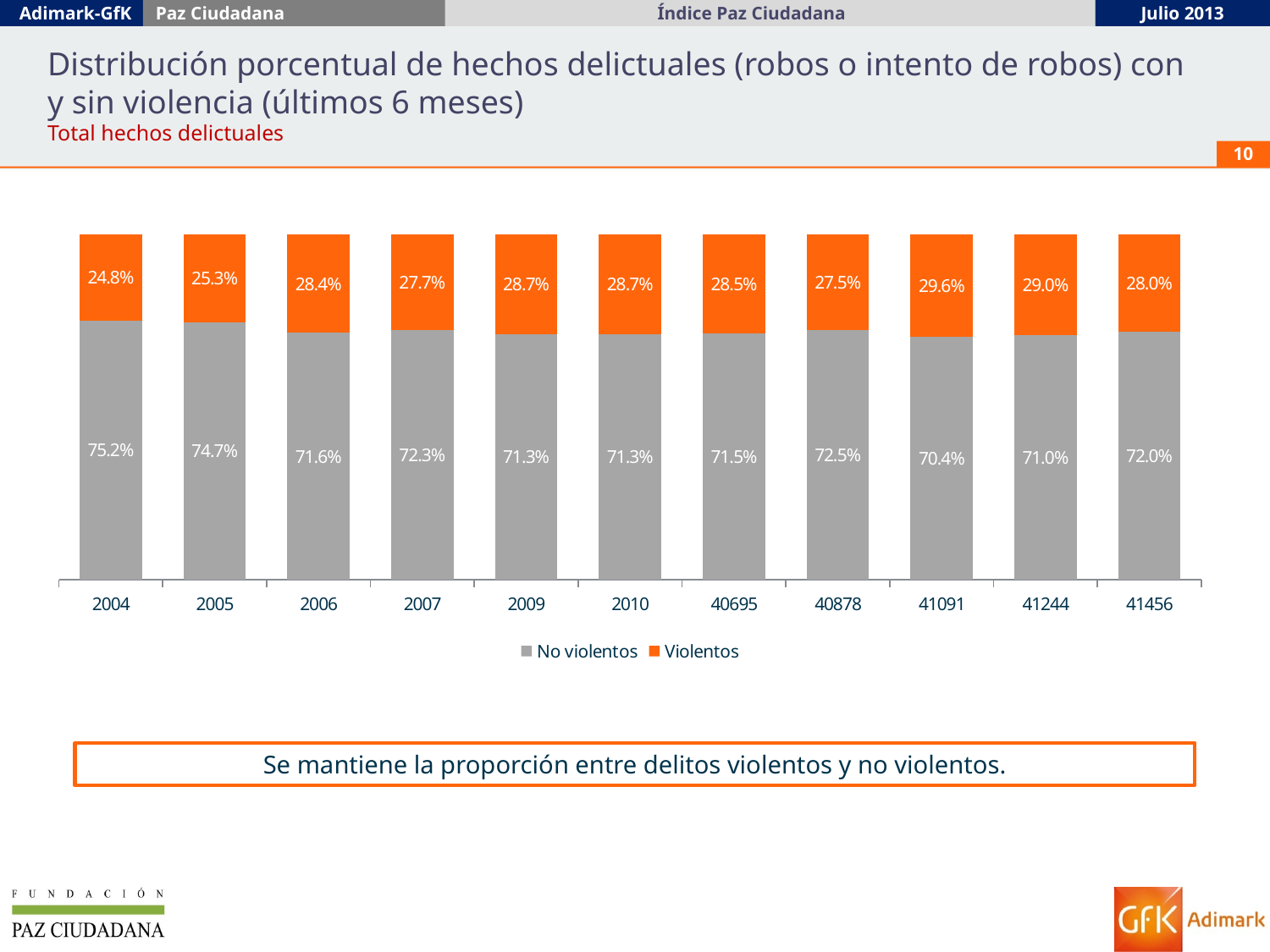
Which category has the highest value for No violentos? 2004 Which series is shown in orange? Violentos What is the difference between the No violentos values for 2004 and 2005? 0.5% What kind of chart is shown on the slide? Stacked bar chart Which is larger, the Violentos value for 2006 or for 2007? 2006 How many series does the legend list? 2 What is the value for Violentos in 2004? 24.8% How many categories are shown on the x axis? 11 What is the value for Violentos for the category labelled 41456? 28.0% Which category has the highest value for Violentos? 41091 What is the value for No violentos in 2007? 72.3% Which category has the lowest value for No violentos? 41091